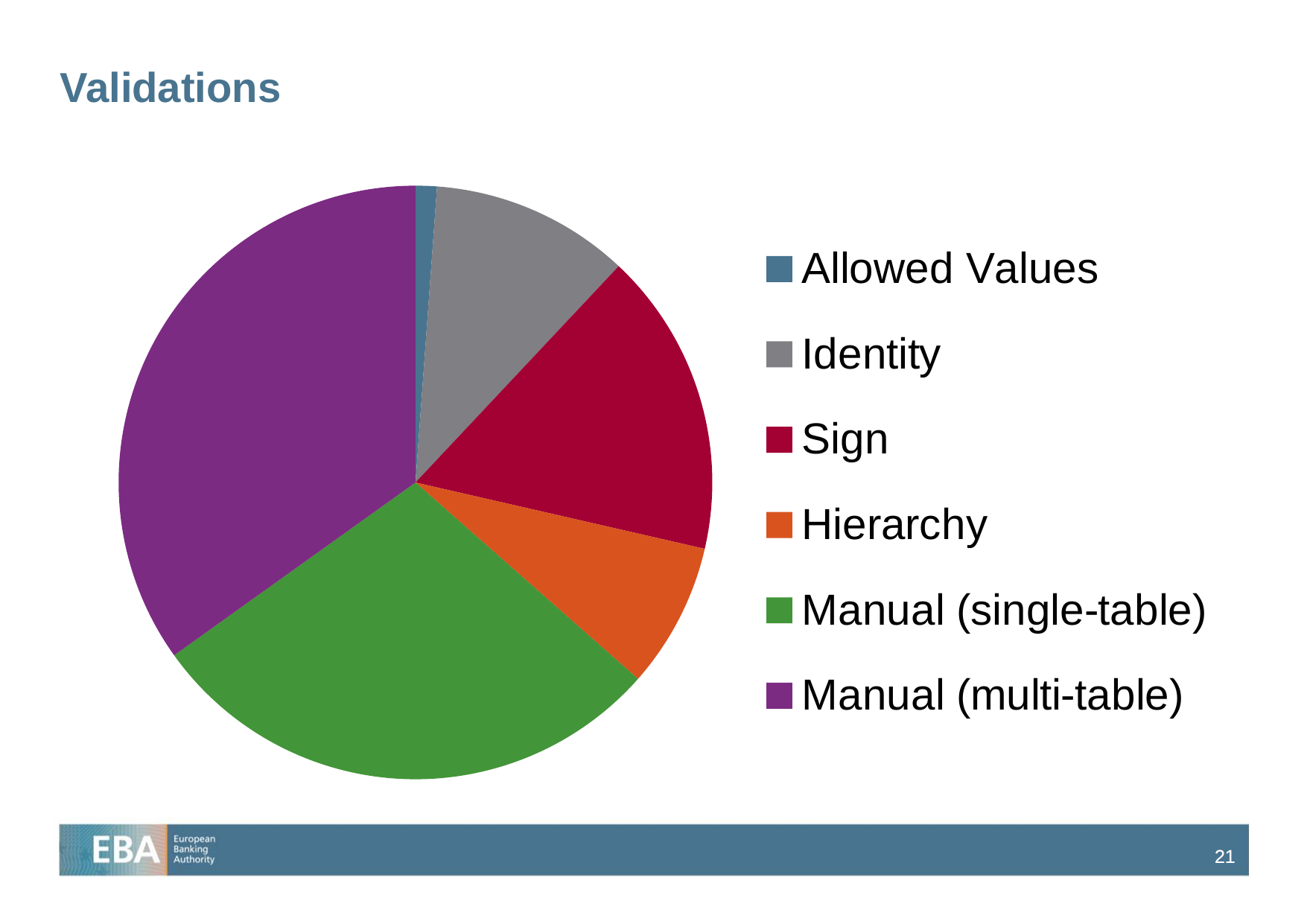
How many slices does the pie chart have? 6 Which slice is larger, Manual (single-table) or Hierarchy? Manual (single-table) Which slice is larger, Sign or Allowed Values? Sign Which slice is larger, Identity or Hierarchy? Identity What is the title of the slide containing the pie chart? Validations Which category is shown in green in the pie chart? Manual (single-table) Which category has the largest slice of the pie chart? Manual (multi-table) How many entries does the legend of the pie chart list? 6 What kind of chart is shown on the slide? pie chart Which category has the smallest slice of the pie chart? Allowed Values